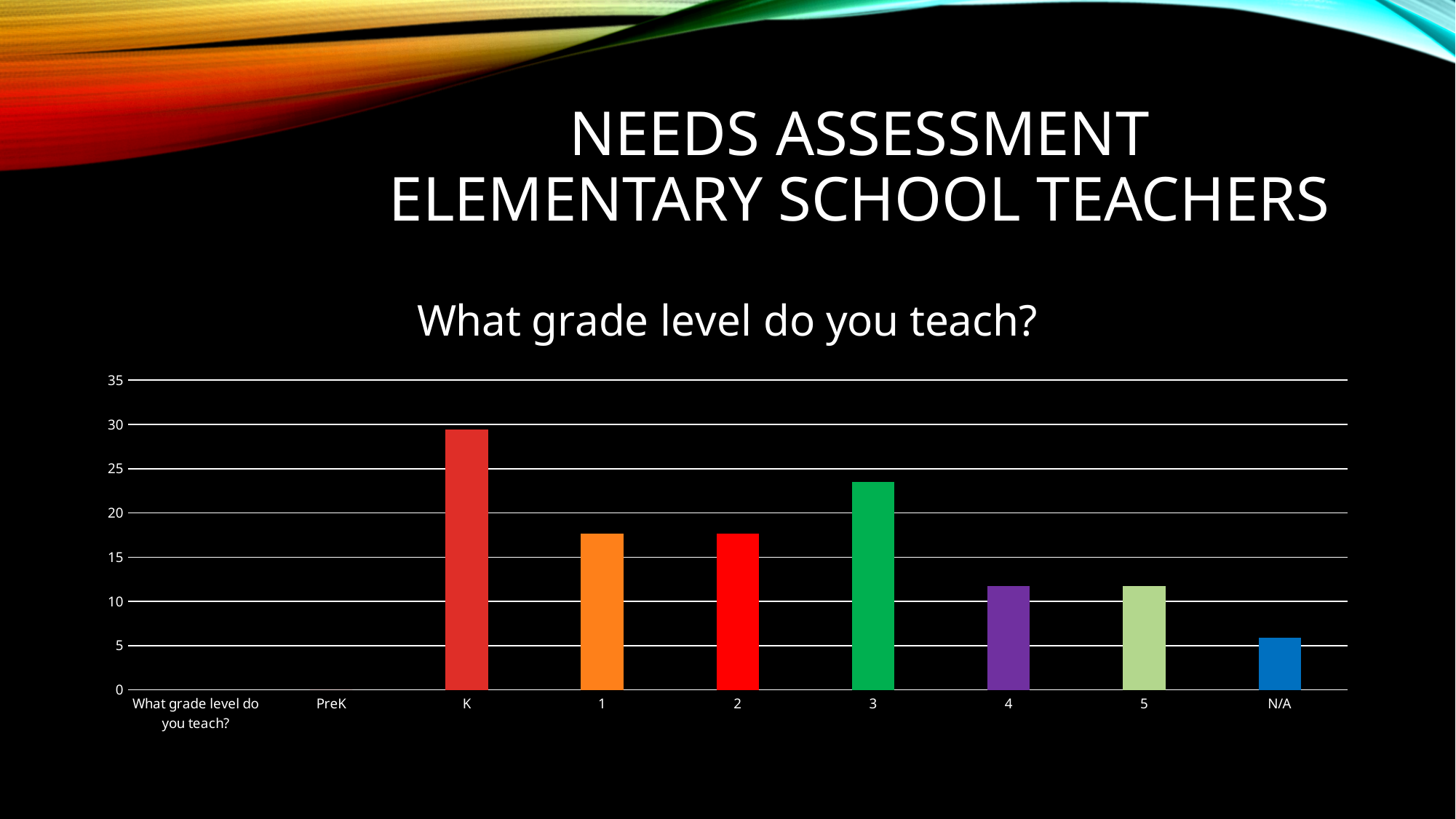
Among the bars shown in the chart, which category has the lowest value? N/A What kind of chart is shown on the slide? bar chart Is the value for K greater or less than 25? greater Which grade level has the highest value in the chart? K Is the value for 3 greater or less than 20? greater What is the title of the chart? What grade level do you teach? Which has a larger value, 3 or 1? 3 Is the value for 1 greater or less than 20? less Which has a larger value, K or 3? K Which has a larger value, 4 or N/A? 4 How many category labels are shown along the x axis of the chart? 9